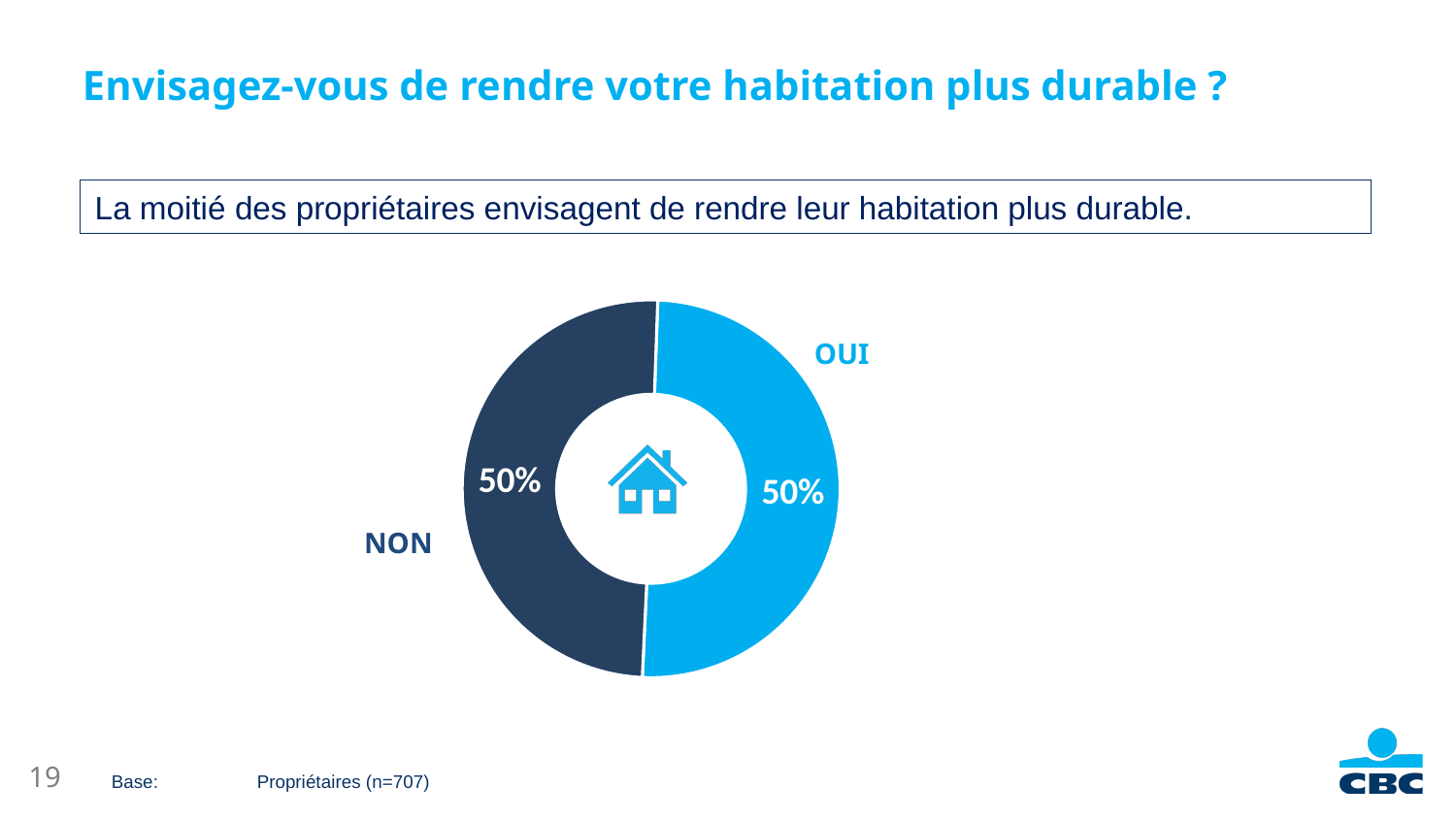
What is the difference between the OUI and NON shares? 0% What share of the chart does the OUI slice represent? 50% What kind of chart is shown on the slide? Doughnut chart Which colour is used for the OUI slice? Light blue Is the value for NON greater or less than 40%? greater How many categories does the chart show? 2 Is the value for OUI greater or less than 60%? less What is the total of the OUI and NON values? 100% What percentage of respondents answered OUI? 50% What is the title of the slide containing the chart? Envisagez-vous de rendre votre habitation plus durable ? What percentage of respondents answered NON? 50%